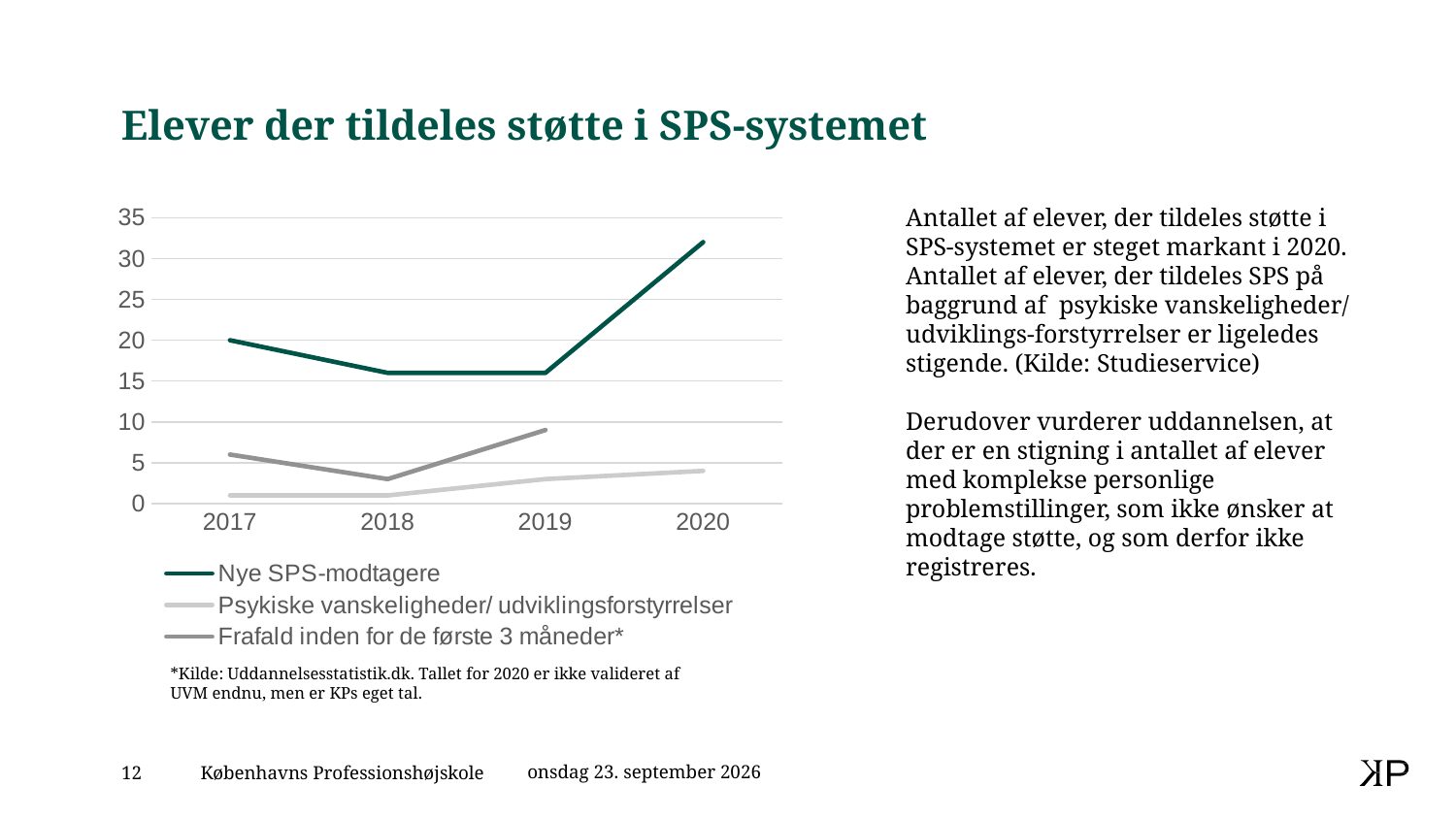
How many series does the chart legend list? 3 How many years are shown on the x axis of the chart? 4 Is the value for Nye SPS-modtagere in 2018 greater or less than 20? less In which year is the value for Frafald inden for de første 3 måneder* lowest? 2018 What kind of chart is shown on the slide? Line chart What is the title of the slide containing the chart? Elever der tildeles støtte i SPS-systemet Is the value for Frafald inden for de første 3 måneder* in 2019 greater or less than 5? greater Is the value for Nye SPS-modtagere in 2020 greater or less than 30? greater In 2019, which series has the higher value: Nye SPS-modtagere or Frafald inden for de første 3 måneder*? Nye SPS-modtagere Does the value for Nye SPS-modtagere rise or fall from 2019 to 2020? Rise In which year is the value for Nye SPS-modtagere highest? 2020